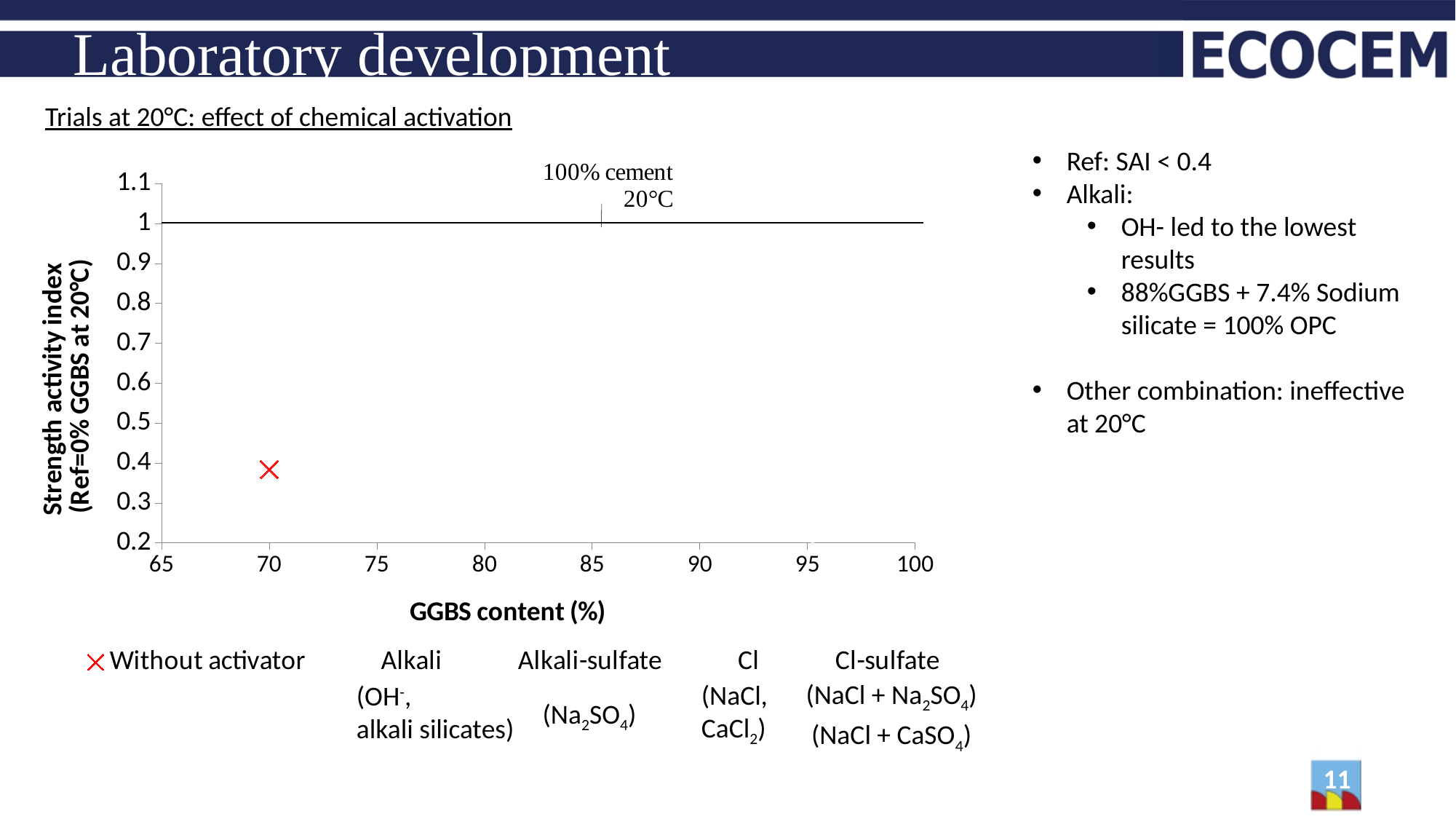
How many entries does the legend below the chart list? 5 What is the title of the x axis? GGBS content (%) Is the 'Without activator' point above or below the 100% cement reference line? below At what GGBS content (%) is the 'Without activator' point plotted? 70 What is the lowest value shown on the x axis? 65 What strength activity index value does the horizontal reference line for 100% cement sit at? 1 How many data points are plotted on the chart? 1 Is the strength activity index of the 'Without activator' point greater or less than 0.3? greater What marker represents 'Without activator' in the legend? a red X What is the highest value shown on the y axis? 1.1 What kind of chart is shown on the slide? scatter chart Is the strength activity index of the 'Without activator' point greater or less than 0.5? less